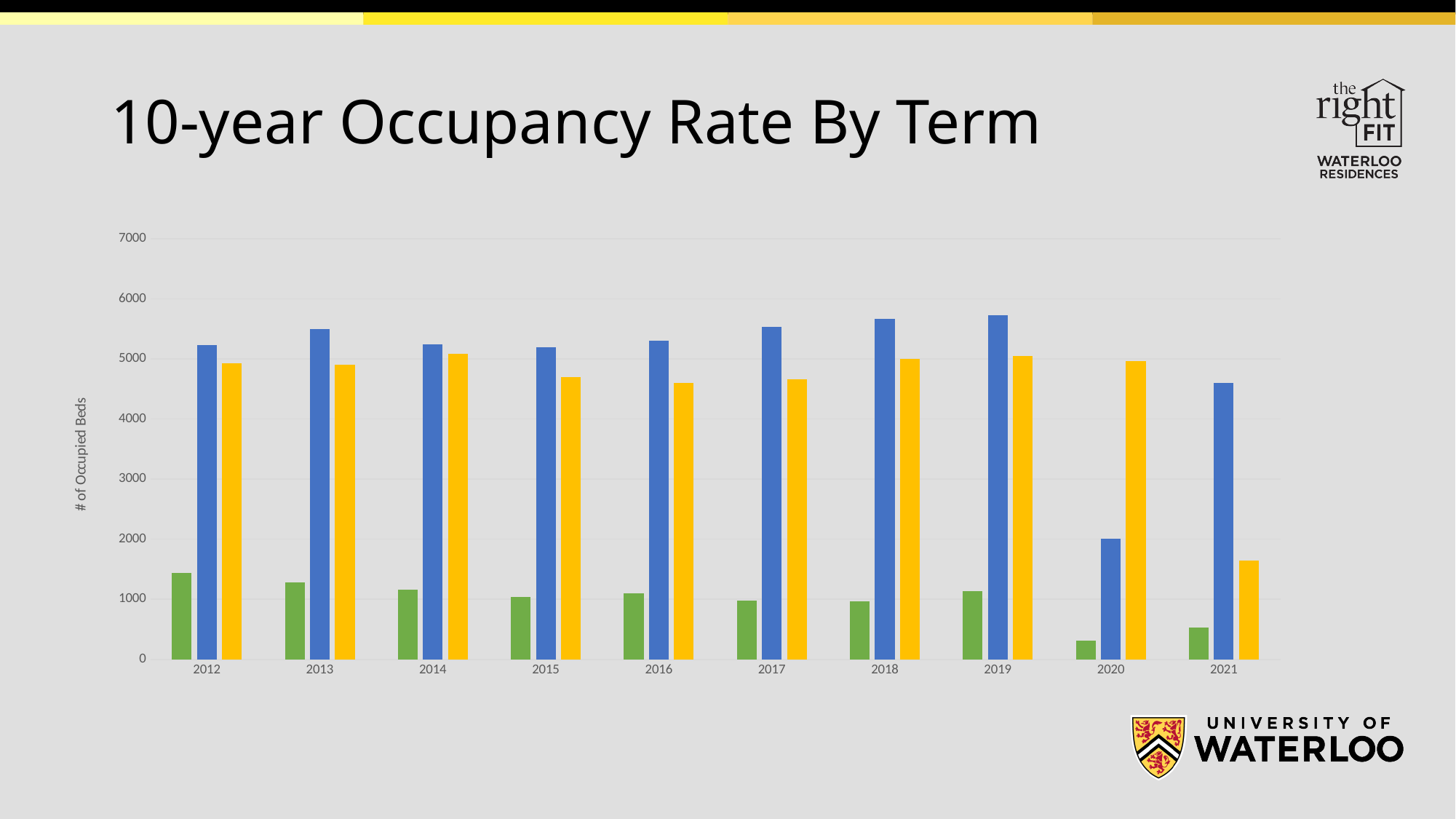
What kind of chart is shown on the slide? bar chart Is the value of the blue bar for 2019 greater or less than 6000? less In 2020, which is larger: the blue bar or the yellow bar? the yellow bar What is the label on the vertical axis of the chart? # of Occupied Beds Do the green bars generally rise or fall from 2012 to 2021? fall Is the value of the blue bar for 2021 greater or less than 4000? greater Is the value of the yellow bar for 2016 greater or less than 5000? less In which year is the green bar the highest? 2012 How many years are shown along the x axis of the chart? 10 What is the title of the chart on the slide? 10-year Occupancy Rate By Term In which year is the blue bar the lowest? 2020